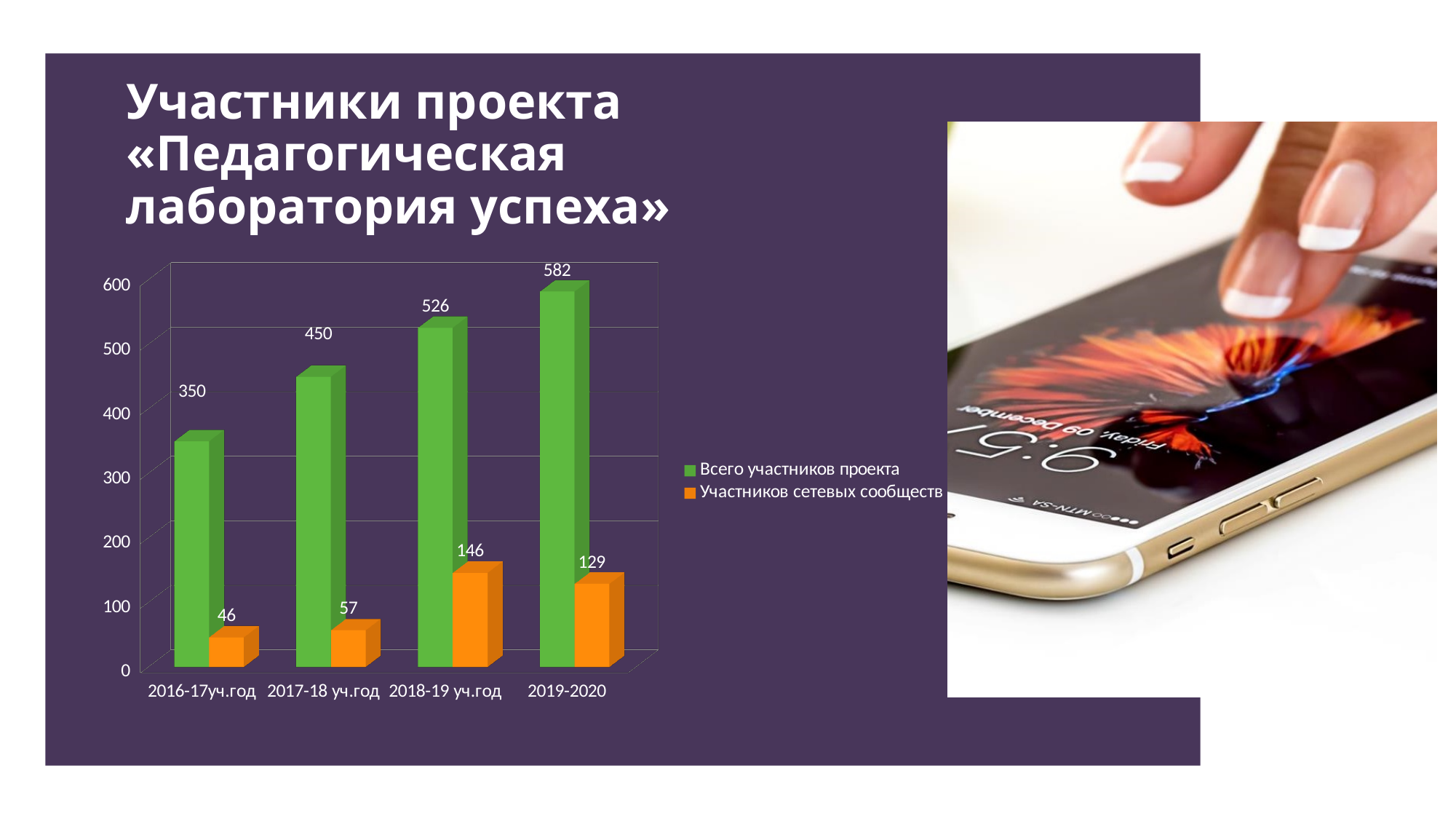
Which is larger: 'Участников сетевых сообществ' in 2018-19 уч.год or in 2019-2020? 2018-19 уч.год What is the value for 'Всего участников проекта' in 2016-17уч.год? 350 What is the value for 'Участников сетевых сообществ' in 2018-19 уч.год? 146 Do the values for 'Всего участников проекта' rise or fall from 2016-17уч.год to 2019-2020? rise Which year has the lowest value for 'Всего участников проекта'? 2016-17уч.год How many years (categories) are shown on the x axis? 4 Which year has the highest value for 'Участников сетевых сообществ'? 2018-19 уч.год How many series does the legend list? 2 Which colour represents 'Участников сетевых сообществ' in the legend? orange What kind of chart is shown on the slide? bar chart What is the difference between 'Всего участников проекта' in 2019-2020 and in 2018-19 уч.год? 56 What is the value for 'Всего участников проекта' in 2019-2020? 582